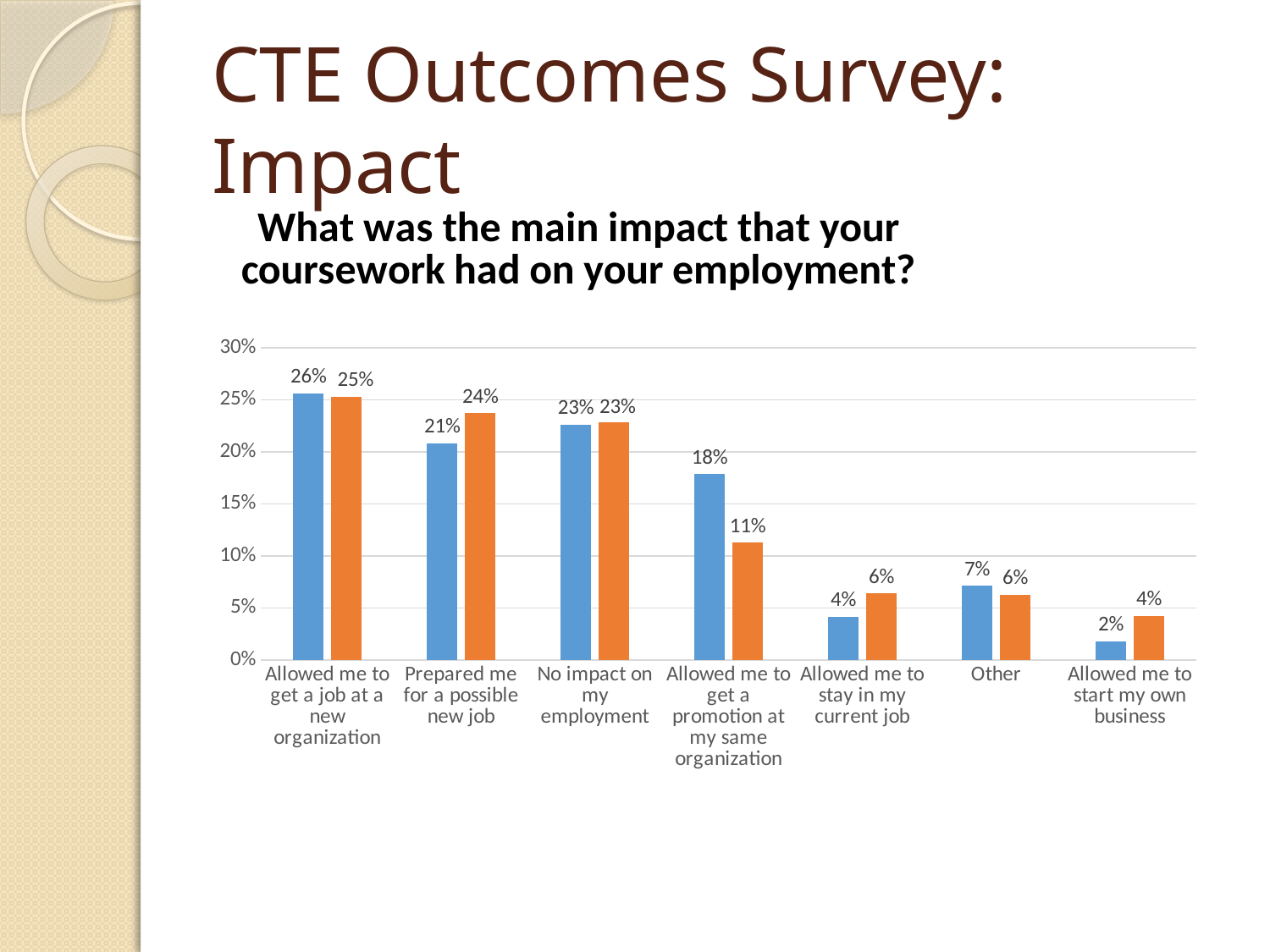
What is the difference between the blue and orange bars for "Allowed me to get a promotion at my same organization"? 7% Which category has the highest blue bar? Allowed me to get a job at a new organization What kind of chart is shown on the slide? bar chart What is the value of the orange bar for "Allowed me to get a promotion at my same organization"? 11% How many categories are shown on the x axis of the chart? 7 Which category has the lowest blue bar? Allowed me to start my own business What is the value of the blue bar for "Allowed me to get a job at a new organization"? 26% What is the value of the blue bar for "Allowed me to start my own business"? 2% Is the blue bar for "Other" greater or less than 5%? greater For "Prepared me for a possible new job", which bar is larger, the blue or the orange? orange What is the value of the orange bar for "Prepared me for a possible new job"? 24% What question does the chart's title ask? What was the main impact that your coursework had on your employment?